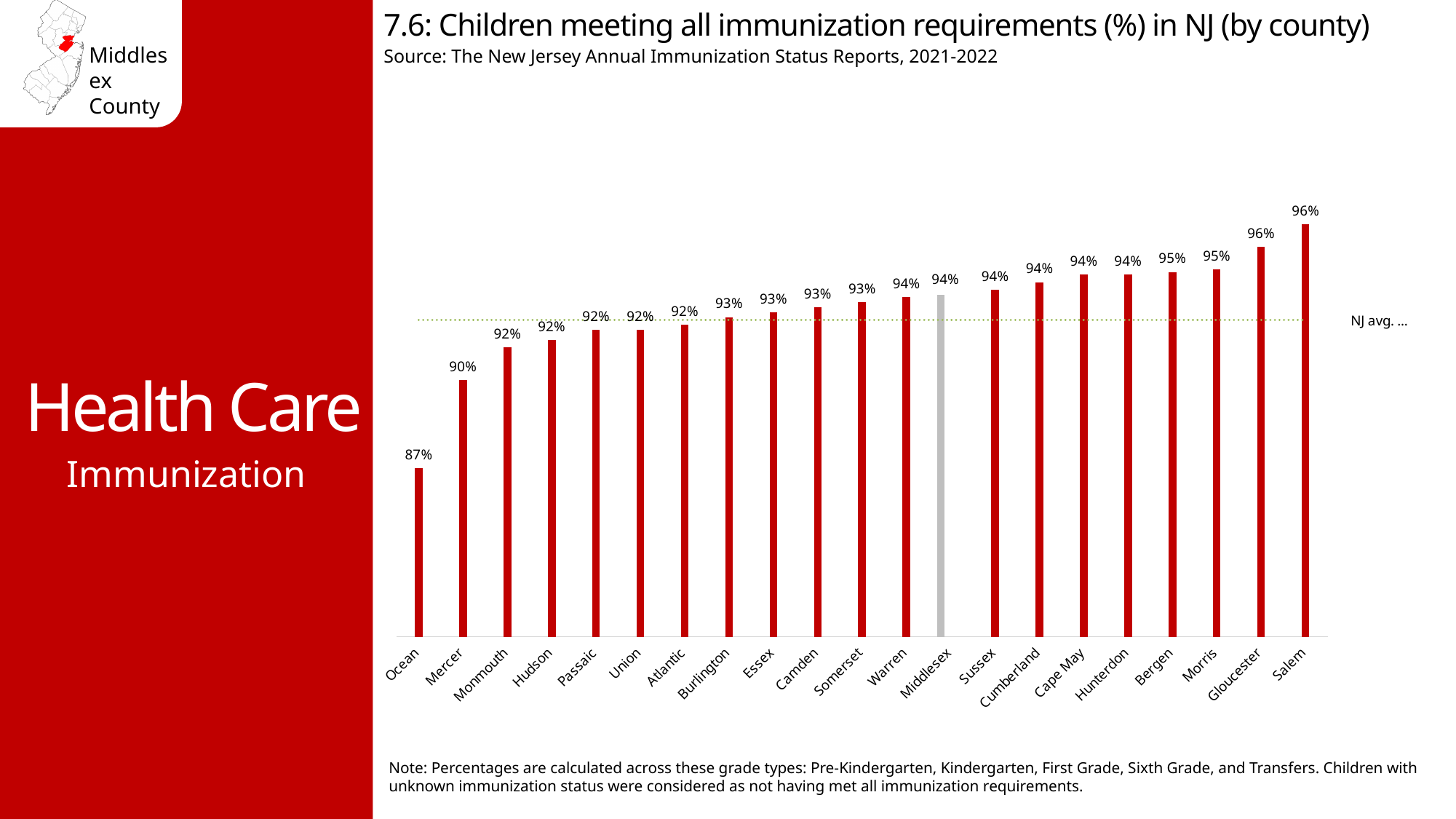
What kind of chart is used on this slide? Bar chart Which county's bar is shown in grey instead of red? Middlesex What is the value shown for Ocean County? 87% What is the difference in percentage points between Salem (96%) and Ocean (87%)? 9 percentage points Do the values generally rise or fall from left to right across the counties? Rise How many counties are shown in the chart? 21 What is the value shown for Mercer County? 90% Which has a higher value, Ocean or Mercer? Mercer Which county has the tallest bar in the chart? Salem Which county has the lowest percentage of children meeting all immunization requirements? Ocean What percentage of children in Middlesex County met all immunization requirements? 94% What percentage is shown for Bergen County? 95%